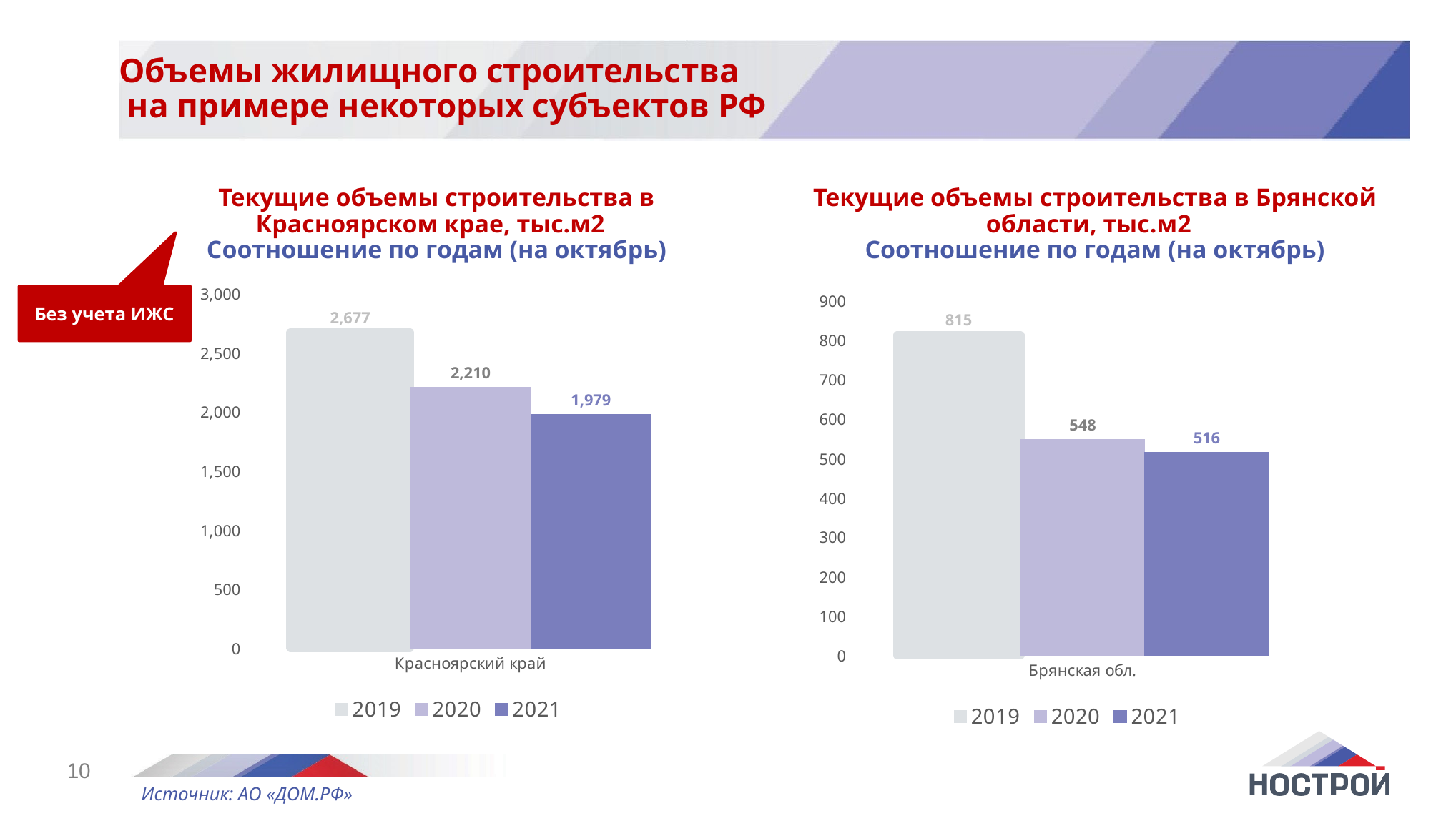
In the left chart (Красноярский край), what is the difference between the 2019 and 2020 values? 467 What kind of chart is the left chart (Красноярский край)? bar chart In the left chart (Красноярский край), which year has the lowest value? 2021 In the left chart (Красноярский край), what is the value for 2019? 2,677 In the right chart (Брянская обл.), what is the value for 2020? 548 In the left chart (Красноярский край), is the value for 2020 greater or less than 2,000? greater In the right chart (Брянская обл.), which is larger: the value for 2019 or the value for 2021? 2019 In the right chart (Брянская обл.), do the values rise or fall from 2019 to 2021? fall In the right chart (Брянская обл.), what is the difference between the 2020 and 2021 values? 32 How many series does the legend of the right chart (Брянская обл.) list? 3 In the left chart (Красноярский край), what is the value for 2021? 1,979 In the right chart (Брянская обл.), which year has the highest value? 2019